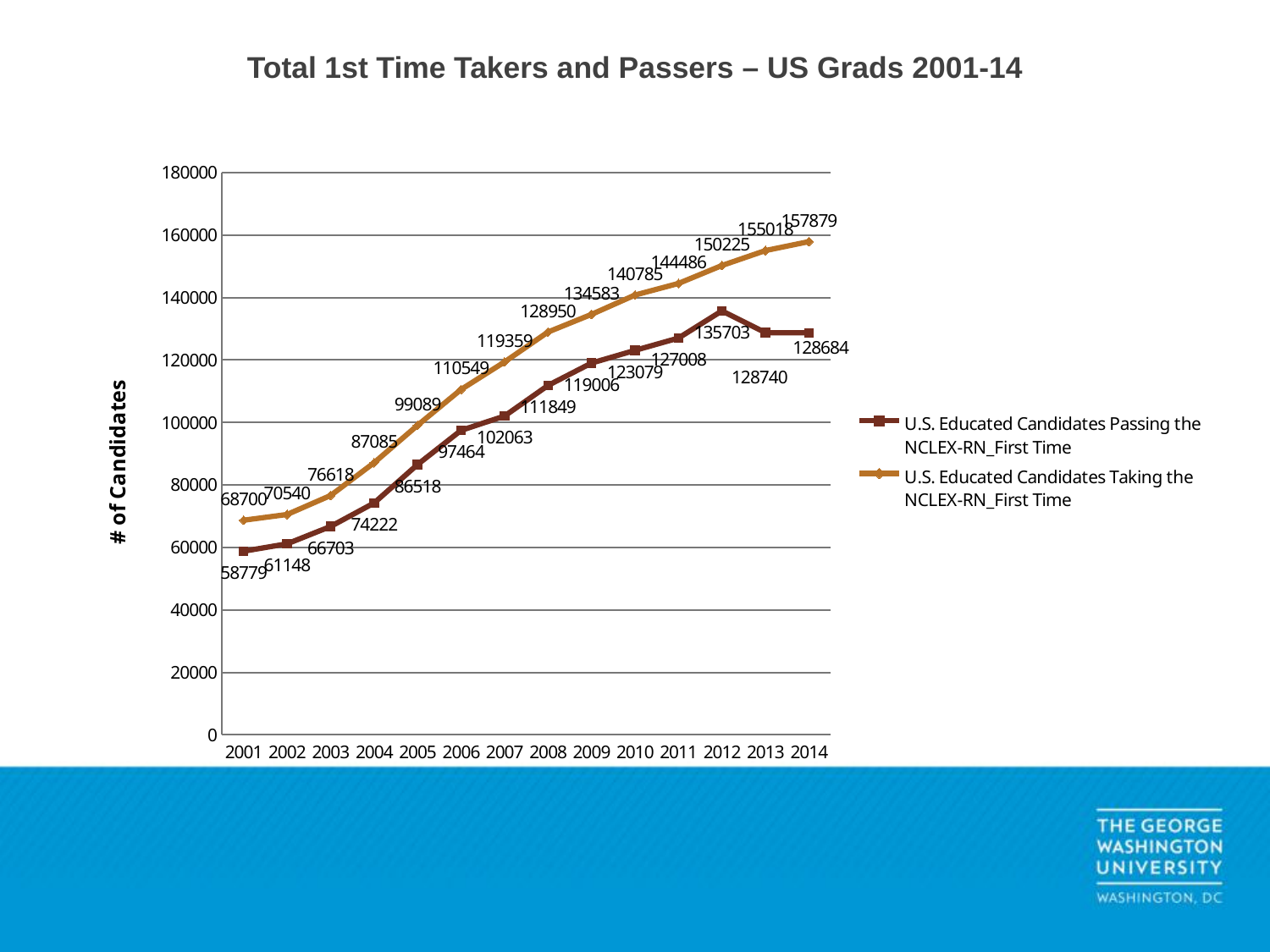
In which year is the number of U.S. Educated Candidates Taking the NCLEX-RN_First Time lowest? 2001 What is the value for U.S. Educated Candidates Passing the NCLEX-RN_First Time in 2012? 135703 In which year is the number of U.S. Educated Candidates Passing the NCLEX-RN_First Time highest? 2012 How many years are plotted on the x axis? 14 What is the value for U.S. Educated Candidates Taking the NCLEX-RN_First Time in 2014? 157879 By how much did the number of U.S. Educated Candidates Passing the NCLEX-RN_First Time fall from 2012 to 2013? 6963 Which is larger: the number of candidates passing in 2011 or the number of candidates taking in 2009? Taking in 2009 How many series does the legend list? 2 Does the number of U.S. Educated Candidates Taking the NCLEX-RN_First Time rise or fall from 2001 to 2014? Rise Is the value for U.S. Educated Candidates Passing the NCLEX-RN_First Time in 2006 greater or less than 100000? less In 2014, what is the difference between the number of candidates taking and the number passing the NCLEX-RN for the first time? 29195 What kind of chart is shown on the slide? Line chart